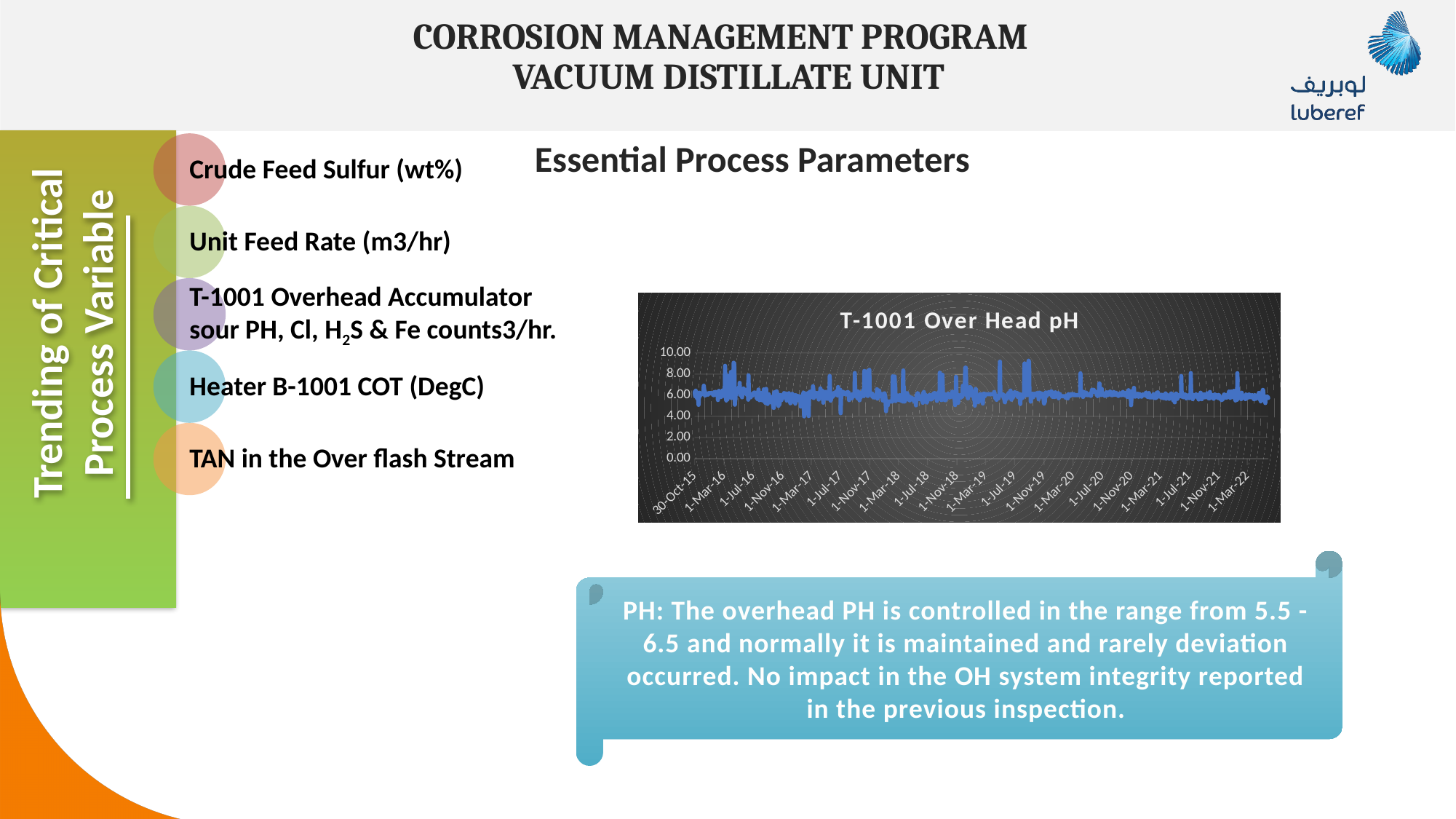
In the T-1001 Over Head pH chart, is the value at 1-Mar-22 greater or less than 4.00? greater In the T-1001 Over Head pH chart, does the pH show a strong rising trend, a strong falling trend, or stay roughly level from 30-Oct-15 to 1-Mar-22? roughly level How many date labels are shown on the x axis of the T-1001 Over Head pH chart? 20 In the T-1001 Over Head pH chart, is the highest peak of the line greater or less than 10.00? less What is the title of the chart on the slide? T-1001 Over Head pH In the T-1001 Over Head pH chart, is the value at 1-Mar-22 greater or less than 8.00? less What colour is the line plotted in the T-1001 Over Head pH chart? blue How many data series are plotted in the T-1001 Over Head pH chart? 1 What kind of chart is the T-1001 Over Head pH chart? line chart